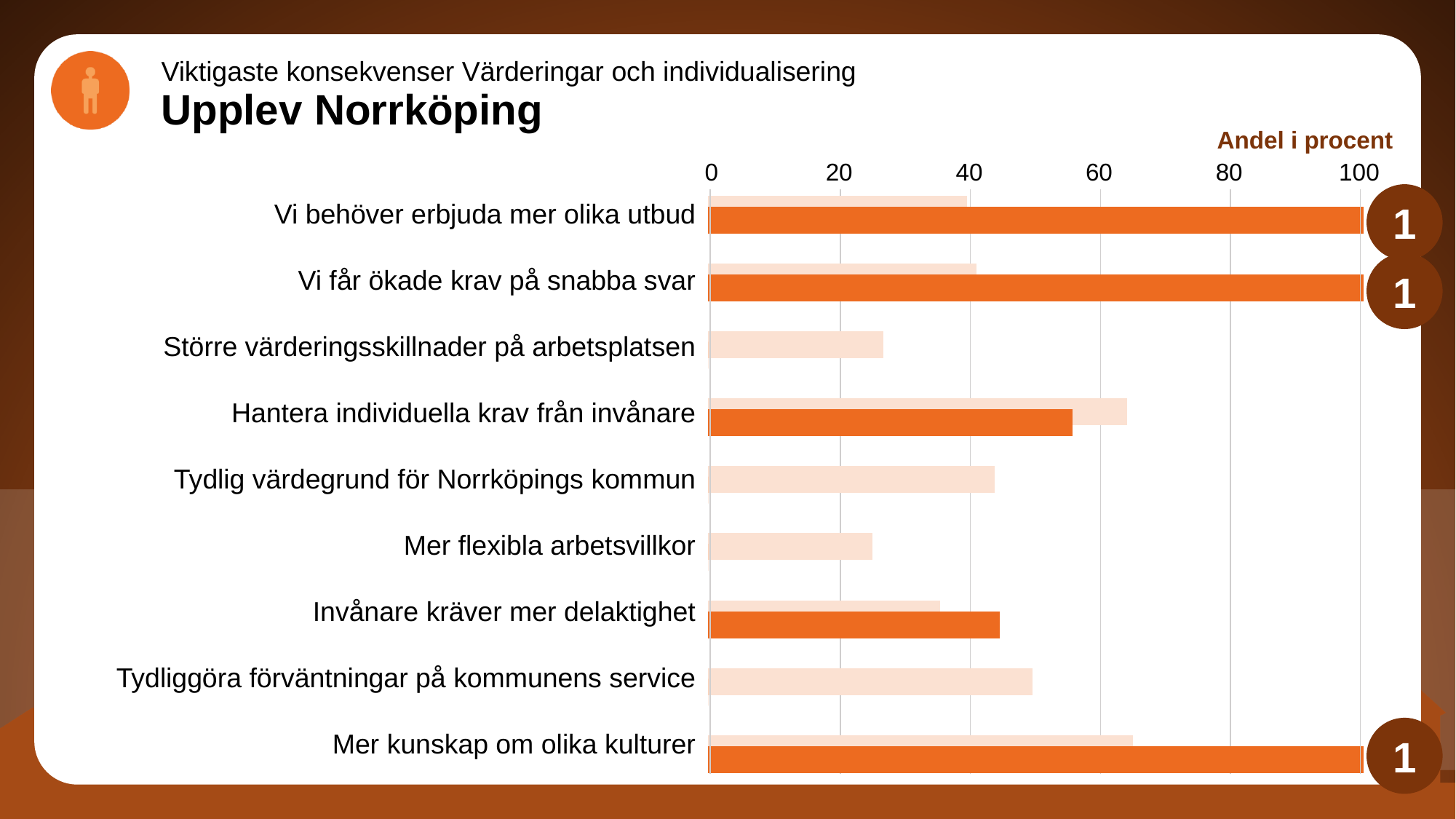
How many categories are listed on the chart? 9 Is the light orange bar for 'Mer flexibla arbetsvillkor' greater or less than 40? less Is the light orange bar for 'Större värderingsskillnader på arbetsplatsen' greater or less than 40? less What kind of chart is shown on the slide? bar chart Is the light orange bar for 'Tydliggöra förväntningar på kommunens service' greater or less than 40? greater What value does the dark orange bar for 'Vi behöver erbjuda mer olika utbud' reach on the axis? 100 Which has the longer light orange bar: 'Tydlig värdegrund för Norrköpings kommun' or 'Större värderingsskillnader på arbetsplatsen'? Tydlig värdegrund för Norrköpings kommun Which has the longer light orange bar: 'Mer kunskap om olika kulturer' or 'Mer flexibla arbetsvillkor'? Mer kunskap om olika kulturer What is the bold title of the slide above the chart? Upplev Norrköping What is the label shown above the horizontal axis of the chart? Andel i procent